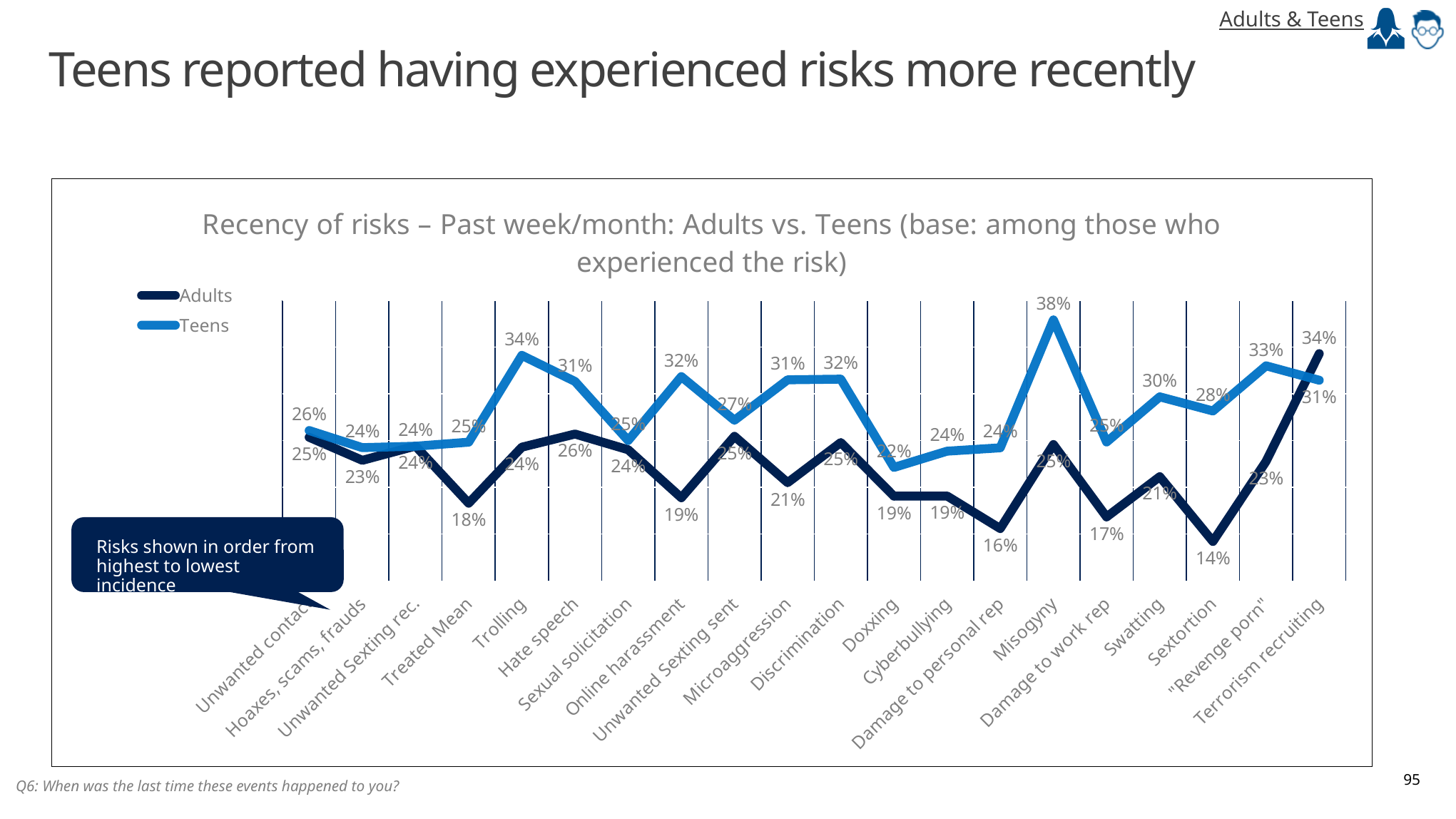
Which risk has the highest Adults value? Terrorism recruiting How many series does the legend list? 2 How many risk categories are plotted along the x axis? 20 What is the Teens value for Misogyny? 38% What is the difference between the Teens and Adults values for Trolling? 10% For Terrorism recruiting, which series has the larger value, Adults or Teens? Adults Which risk has the lowest Adults value? Sextortion Which risk has the highest Teens value? Misogyny What is the Adults value for Sextortion? 14% What type of chart is shown on the slide? line chart What is the Adults value for Treated Mean? 18% What is the title of the chart? Recency of risks – Past week/month: Adults vs. Teens (base: among those who experienced the risk)